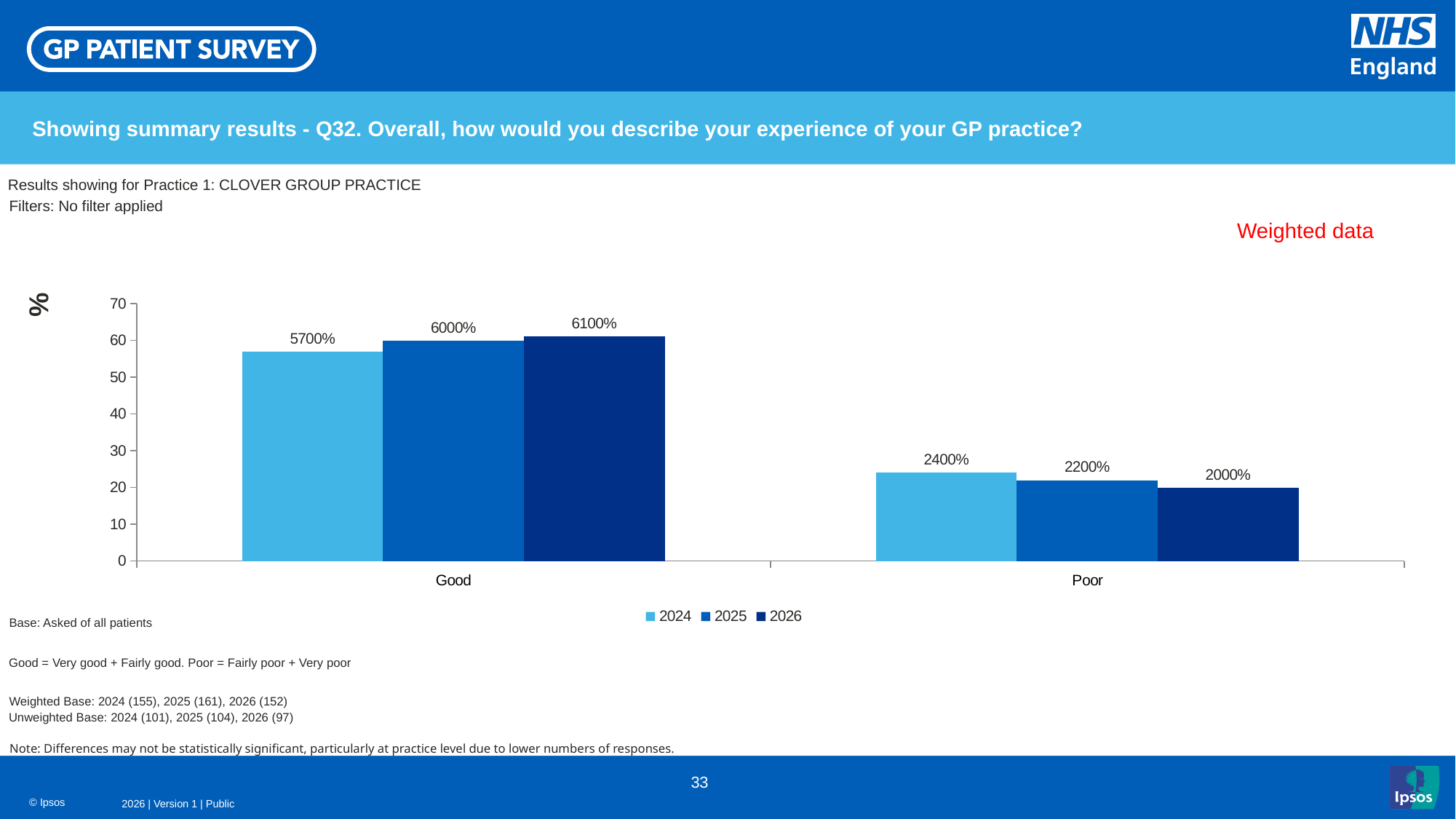
Is the 2025 bar for Poor greater or less than 30 on the axis? less How many categories are shown on the x axis? 2 What is the data label shown for the 2026 series in the Poor category? 2000% Which year has the lowest bar in the Poor category? 2026 What kind of chart is shown on the slide? Bar chart Do the bars for the Poor category rise or fall from 2024 to 2026? Fall Which is larger: the 2024 bar for Good or the 2024 bar for Poor? Good What is the data label shown for the 2024 series in the Good category? 5700% What is the data label shown for the 2025 series in the Poor category? 2200% What is the data label shown for the 2026 series in the Good category? 6100% Which year has the highest bar in the Good category? 2026 How many series does the legend list? 3